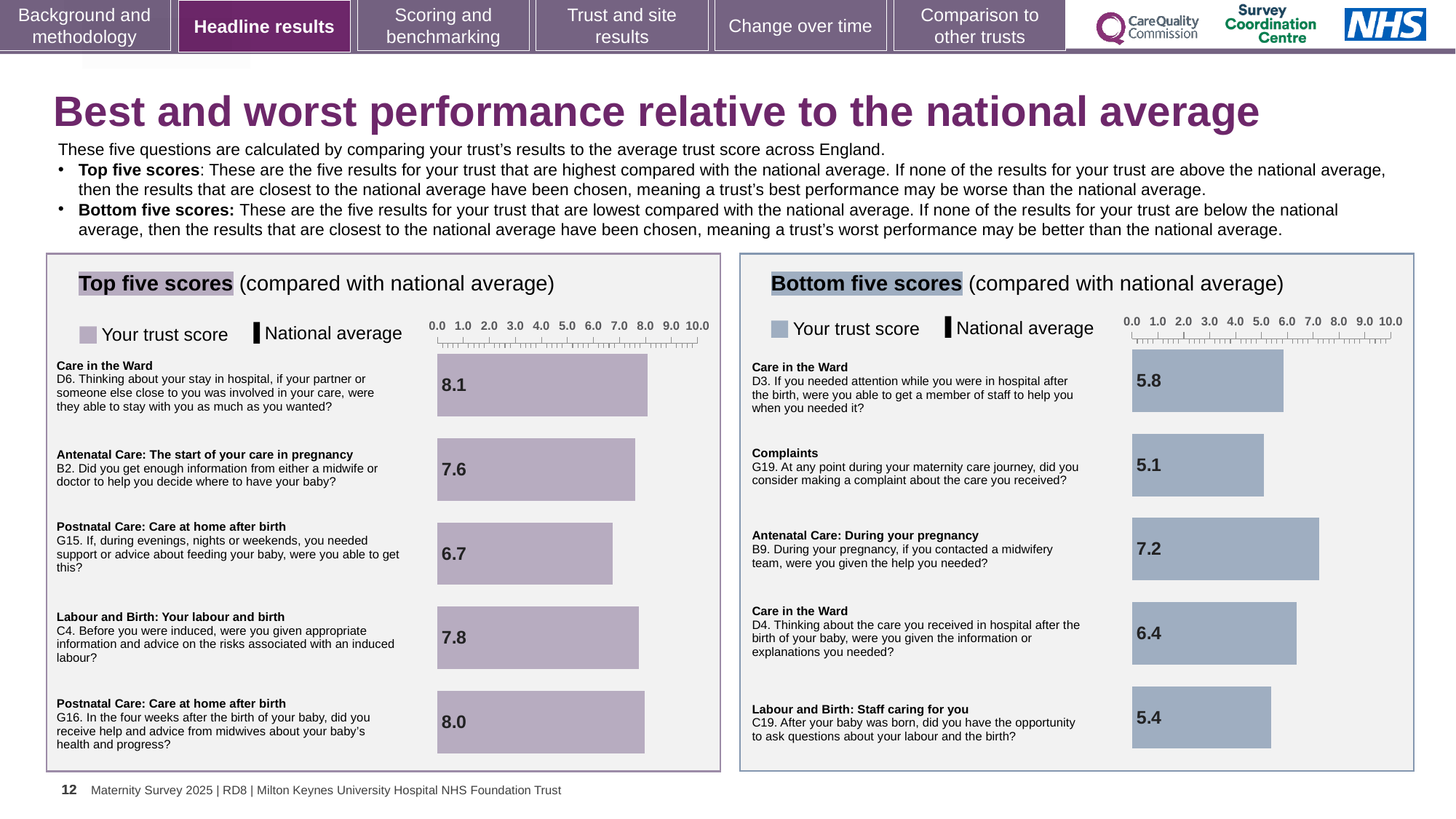
In the Top five scores chart, what is the trust score for question D6 (Care in the Ward)? 8.1 How many bars are plotted in the Top five scores chart? 5 In the Bottom five scores chart, which question has the highest trust score? B9 (Antenatal Care: During your pregnancy) What kind of chart is the Bottom five scores chart? bar chart In the Top five scores chart, what is the difference between the trust scores for D6 and G15? 1.4 In the Top five scores chart, which question has the highest trust score? D6 (Care in the Ward) In the Bottom five scores chart, which has the larger trust score: D3 or D4? D4 In the Bottom five scores chart, what is the trust score for question G19 (Complaints)? 5.1 In the Top five scores chart, what is the trust score for question G16 (Postnatal Care: Care at home after birth)? 8.0 In the Bottom five scores chart, which question has the lowest trust score? G19 (Complaints) In the Top five scores chart, which question has the lowest trust score? G15 (Postnatal Care: Care at home after birth) In the Bottom five scores chart, is the trust score for C19 greater or less than 6.0? less